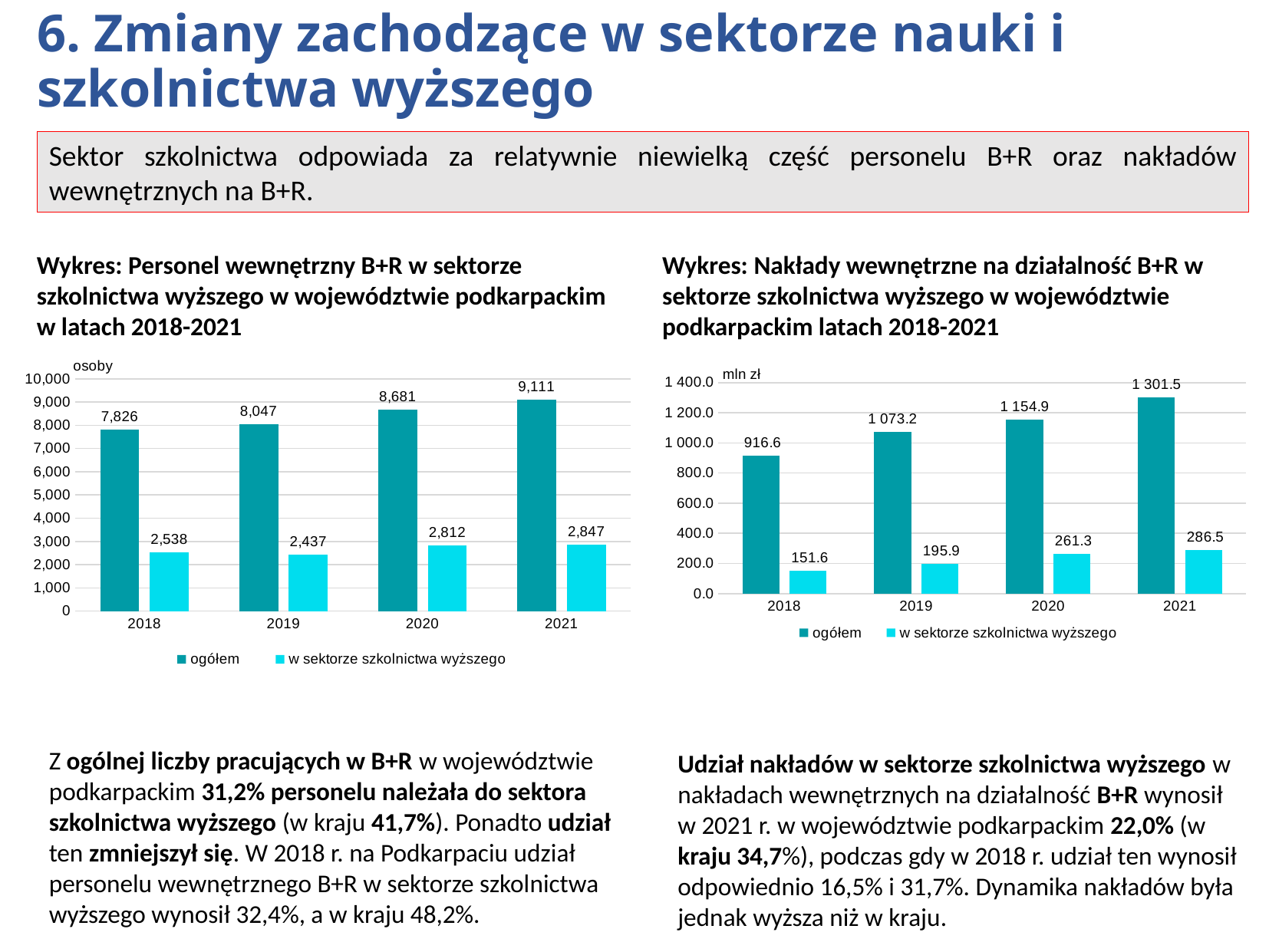
In the right chart (Nakłady wewnętrzne na działalność B+R), how many years are shown on the x axis? 4 In the right chart (Nakłady wewnętrzne na działalność B+R), what is the difference between the 'w sektorze szkolnictwa wyższego' values for 2021 and 2018? 134.9 In the right chart (Nakłady wewnętrzne na działalność B+R), what is the value for 'ogółem' in 2019? 1 073.2 In the right chart (Nakłady wewnętrzne na działalność B+R), which year has the highest value for 'ogółem'? 2021 In the left chart (Personel wewnętrzny B+R), what is the difference between the 'ogółem' values for 2021 and 2018? 1,285 In the left chart (Personel wewnętrzny B+R), what is the value for 'ogółem' in 2021? 9,111 In the left chart (Personel wewnętrzny B+R), what is the value for 'w sektorze szkolnictwa wyższego' in 2019? 2,437 What type of chart is the right chart (Nakłady wewnętrzne na działalność B+R)? bar chart In the left chart (Personel wewnętrzny B+R), how many series does the legend list? 2 In the right chart (Nakłady wewnętrzne na działalność B+R), what is the value for 'w sektorze szkolnictwa wyższego' in 2020? 261.3 In the left chart (Personel wewnętrzny B+R), does the 'ogółem' series rise or fall from 2018 to 2021? rise In the left chart (Personel wewnętrzny B+R), which year has the lowest value for 'w sektorze szkolnictwa wyższego'? 2019